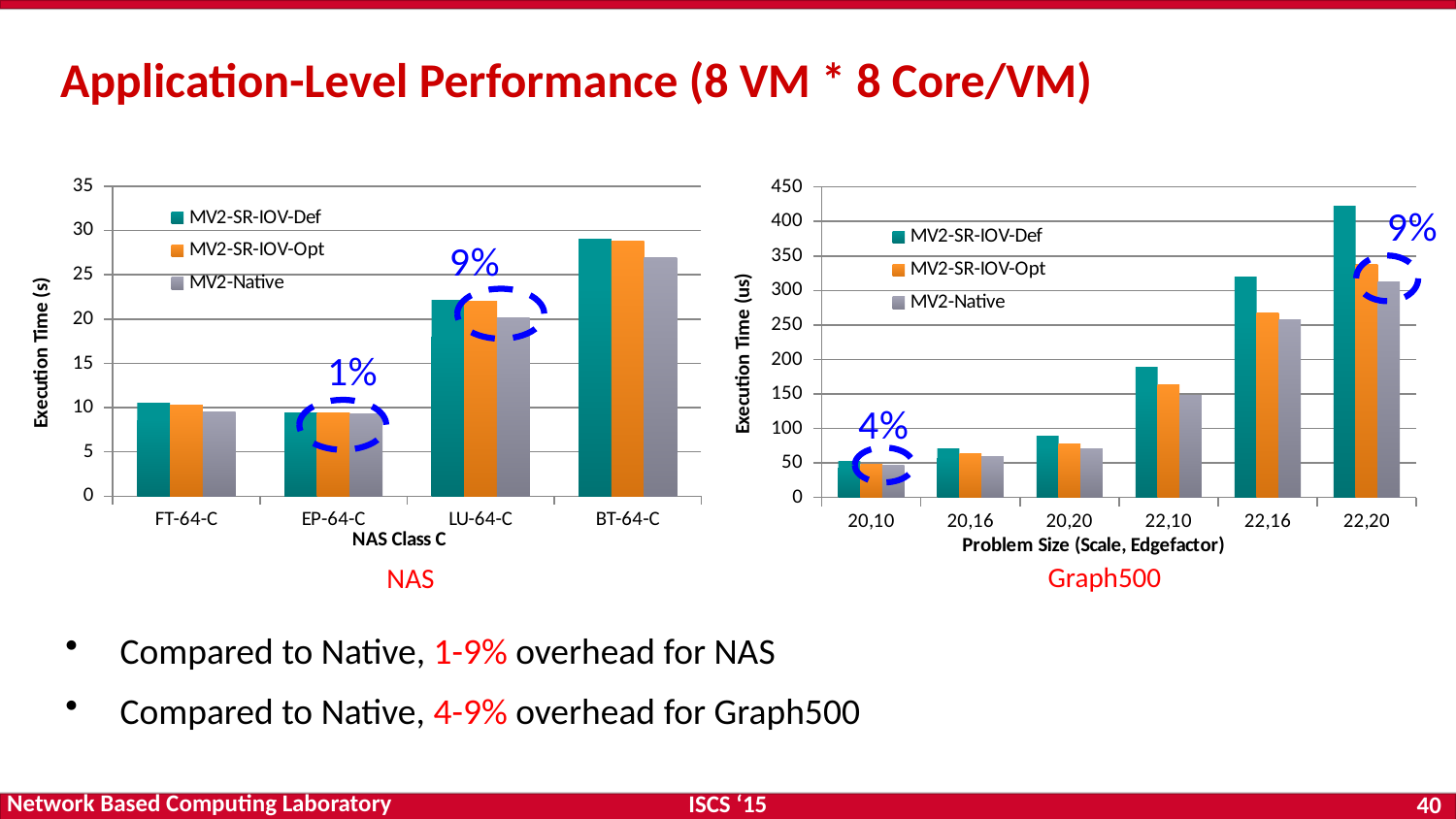
How many problem sizes are shown on the x axis of the Graph500 chart? 6 In the Graph500 chart, is the MV2-SR-IOV-Def value for 22,20 greater or less than 400? greater In the Graph500 chart, which problem size has the highest MV2-SR-IOV-Def execution time? 22,20 In the Graph500 chart, which problem size has the lowest MV2-Native execution time? 20,10 How many series does the legend of the NAS chart list? 3 In the NAS chart, which has the larger MV2-SR-IOV-Def value, FT-64-C or BT-64-C? BT-64-C In the NAS chart, which category has the highest MV2-SR-IOV-Def execution time? BT-64-C In the NAS chart, is the MV2-SR-IOV-Def value for LU-64-C greater or less than 20? greater What kind of chart is the NAS chart on the left? bar chart What is the x-axis title of the Graph500 chart? Problem Size (Scale, Edgefactor) How many categories are shown on the x axis of the NAS chart? 4 In the NAS chart, is the MV2-Native value for BT-64-C greater or less than 30? less